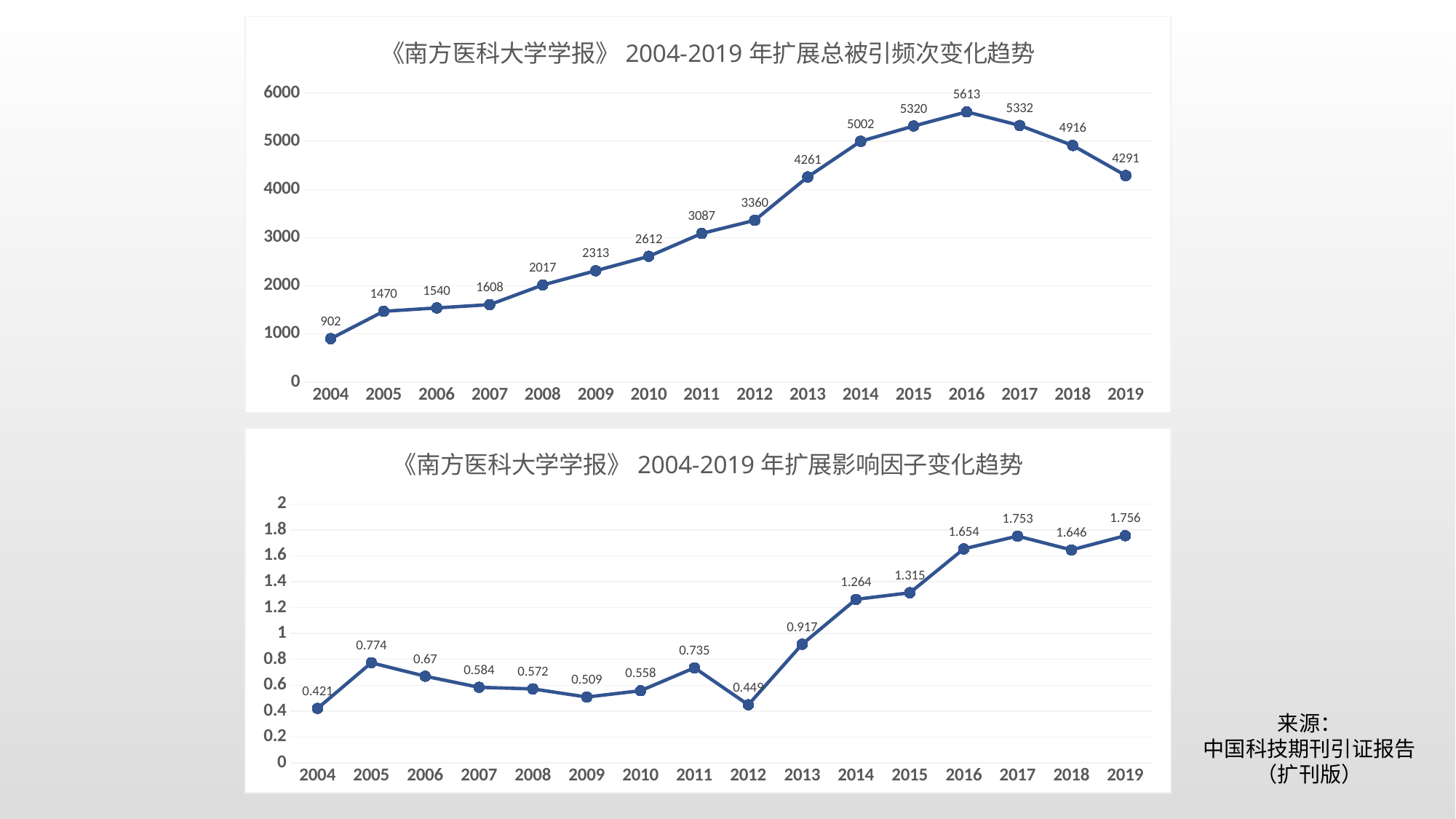
In the bottom chart (扩展影响因子变化趋势), which is larger, the value for 2005 or the value for 2011? 2005 In the top chart (扩展总被引频次变化趋势), which year has the lowest value? 2004 In the bottom chart (扩展影响因子变化趋势), do the values generally rise or fall from 2012 to 2016? rise In the bottom chart (扩展影响因子变化趋势), what is the difference between the values for 2017 and 2018? 0.107 In the top chart (扩展总被引频次变化趋势), is the value for 2013 greater or less than 4000? greater In the top chart (扩展总被引频次变化趋势), what is the difference between the values for 2016 and 2019? 1322 In the bottom chart (扩展影响因子变化趋势), which year has the highest value? 2019 What is the title of the bottom chart? 《南方医科大学学报》 2004-2019 年扩展影响因子变化趋势 In the top chart (扩展总被引频次变化趋势), how many data points are plotted? 16 In the top chart (扩展总被引频次变化趋势), what is the value for 2016? 5613 What kind of chart is the top chart (扩展总被引频次变化趋势)? line chart In the bottom chart (扩展影响因子变化趋势), what is the value for 2012? 0.449